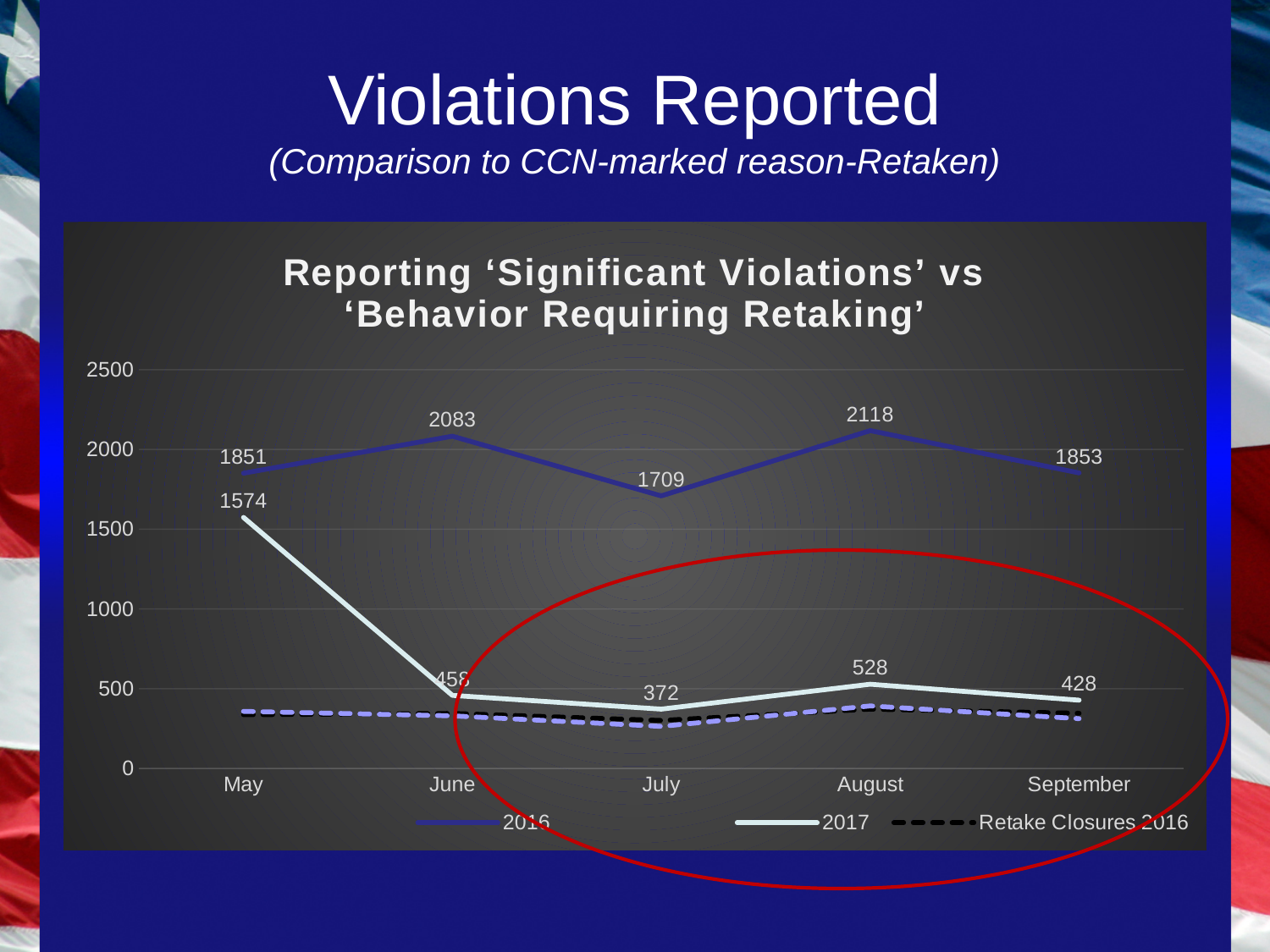
What kind of chart is shown on the slide? line chart Which is larger for the 2016 series: July or September? September In which month is the 2017 series lowest? July What is the value for 2016 in June? 2083 What is the value for 2017 in August? 528 Is the value for Retake Closures 2016 in May greater or less than 500? less Does the 2017 series rise or fall from May to July? fall What is the title of the chart? Reporting 'Significant Violations' vs 'Behavior Requiring Retaking' How many months are shown on the x axis? 5 What is the value for 2016 in September? 1853 What is the difference between the 2016 and 2017 values in May? 277 In which month is the 2016 series highest? August